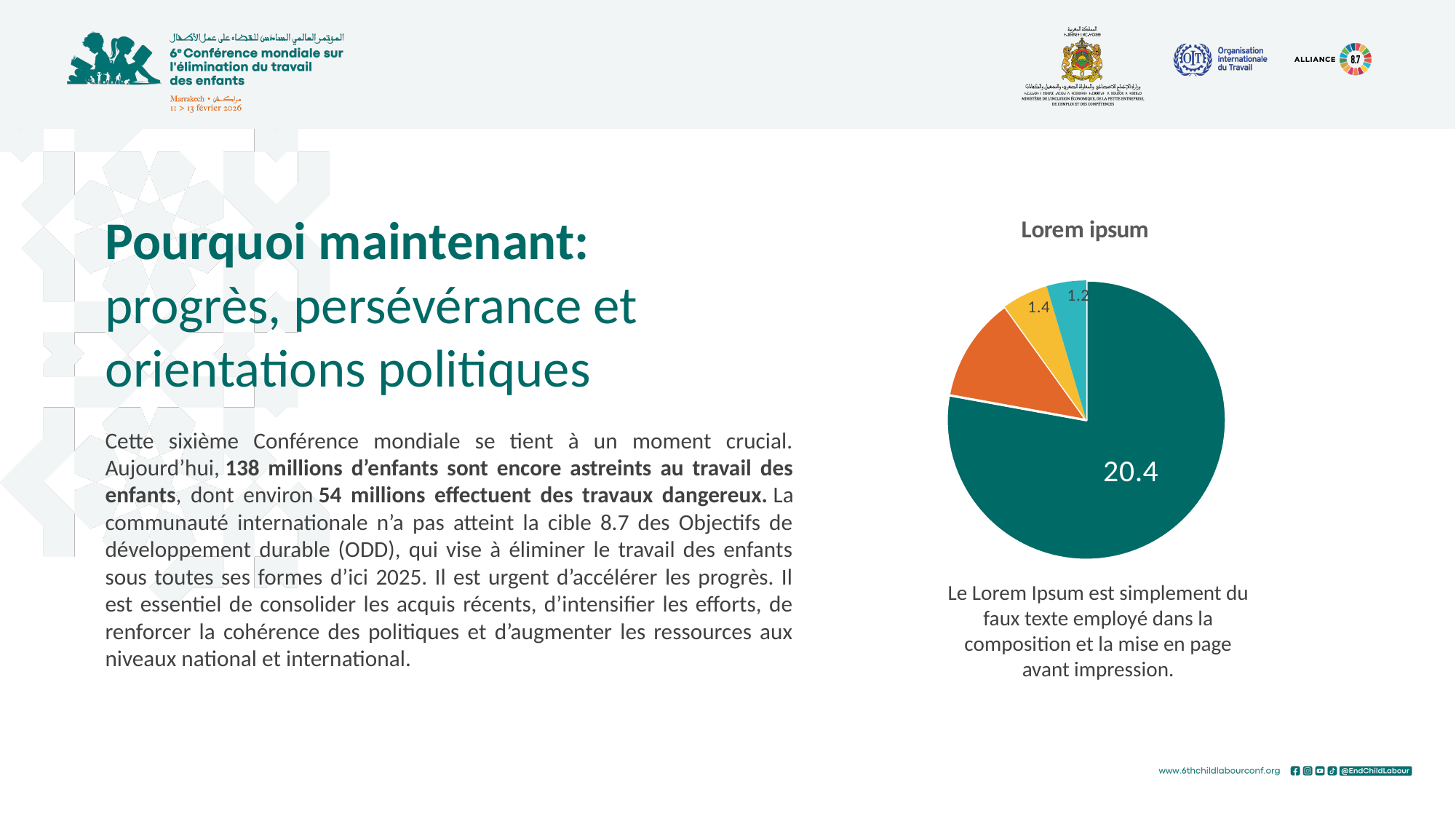
What value is labelled on the largest slice of the pie chart? 20.4 How many slices does the pie chart have? 4 What is the smallest labelled value on the pie chart? 1.2 What is the title of the chart? Lorem ipsum Which is larger, the yellow slice or the light blue slice? the yellow slice What value is labelled on the yellow slice of the pie chart? 1.4 How many slices of the pie chart carry a printed data label? 3 Which is larger, the dark teal slice or the orange slice? the dark teal slice What value is labelled on the light blue slice of the pie chart? 1.2 What colour is the largest slice of the pie chart? dark teal What is the difference between the yellow slice (1.4) and the light blue slice (1.2)? 0.2 What kind of chart is shown on the slide? pie chart